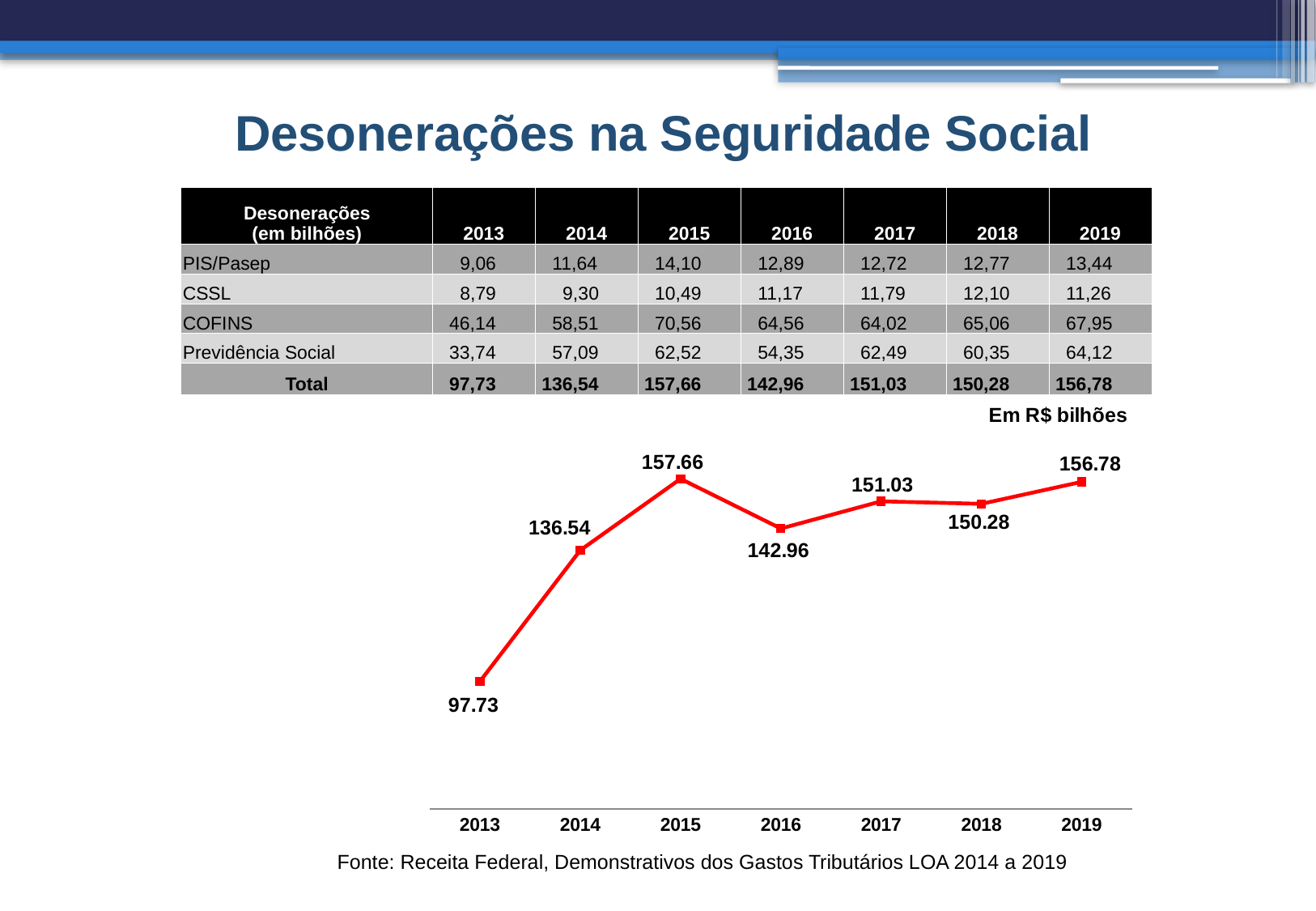
What is the value plotted for 2016 in the line chart? 142.96 What is the value plotted for 2019 in the line chart? 156.78 What is the difference between the values for 2015 and 2016 in the line chart? 14.70 Which year has the lowest value in the line chart? 2013 What is the value plotted for 2013 in the line chart? 97.73 Which is larger in the line chart, the value for 2017 or the value for 2018? 2017 Which year has the highest value in the line chart? 2015 Does the plotted value rise or fall from 2013 to 2015 in the line chart? rise How many years are plotted on the x axis of the line chart? 7 What is the difference between the values for 2014 and 2013 in the line chart? 38.81 What kind of chart is shown on the slide? line chart Which is larger in the line chart, the value for 2019 or the value for 2016? 2019